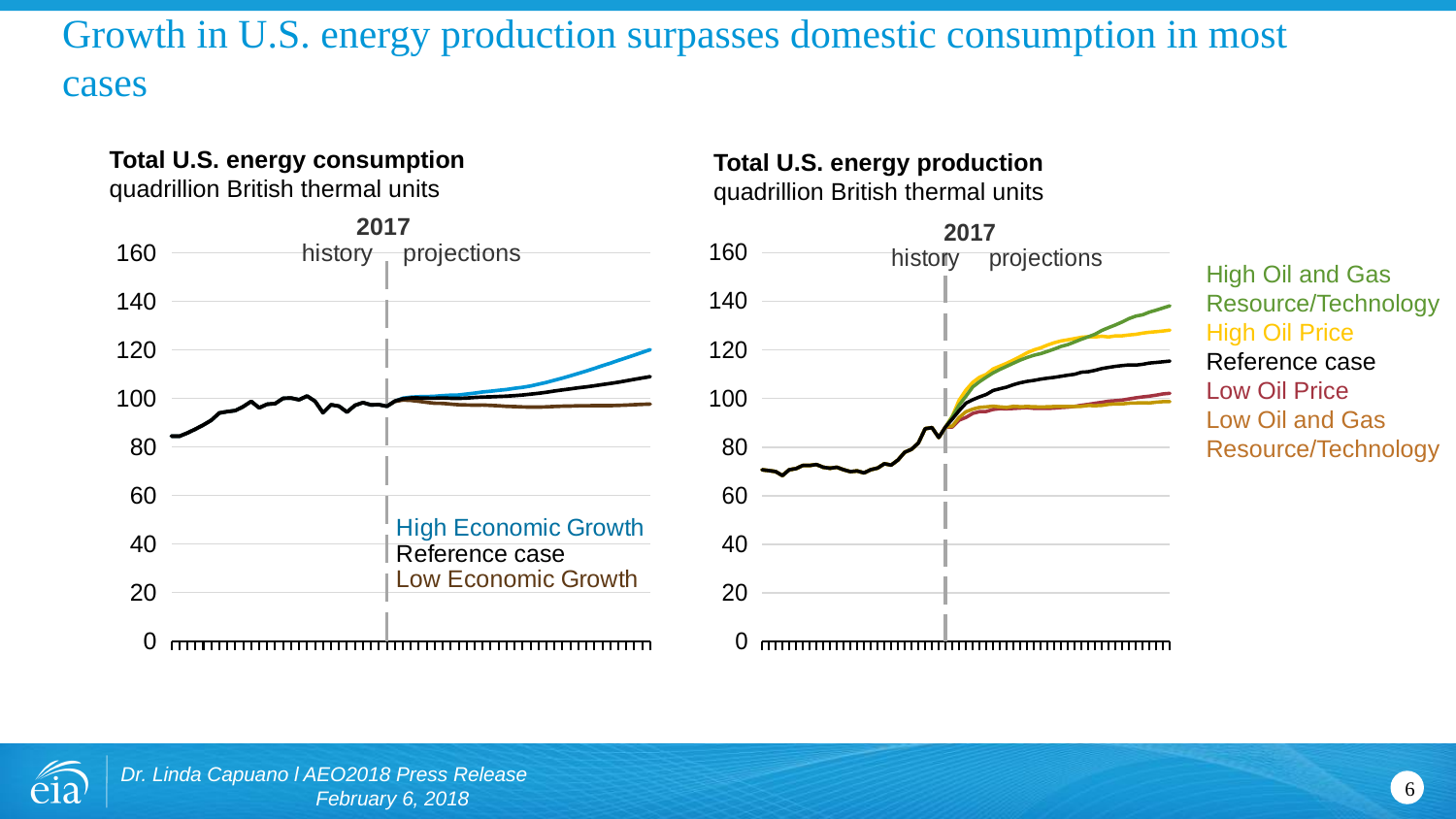
What year separates history from projections in both charts? 2017 In the Total U.S. energy production chart, is the final projected value for High Oil and Gas Resource/Technology greater or less than 120? greater How many series does the legend of the Total U.S. energy production chart list? 5 In the Total U.S. energy consumption chart, is the value at the start of the history period greater or less than 100? less In the Total U.S. energy consumption chart, which series ends higher at the end of the projections, High Economic Growth or Low Economic Growth? High Economic Growth In the Total U.S. energy production chart, does the Reference case rise or fall over the projection period? rise In the Total U.S. energy production chart, which series is highest at the end of the projection period? High Oil and Gas Resource/Technology What kind of chart is the Total U.S. energy consumption chart? line chart In the Total U.S. energy production chart, is the value at the start of the history period greater or less than 80? less How many series does the legend of the Total U.S. energy consumption chart list? 3